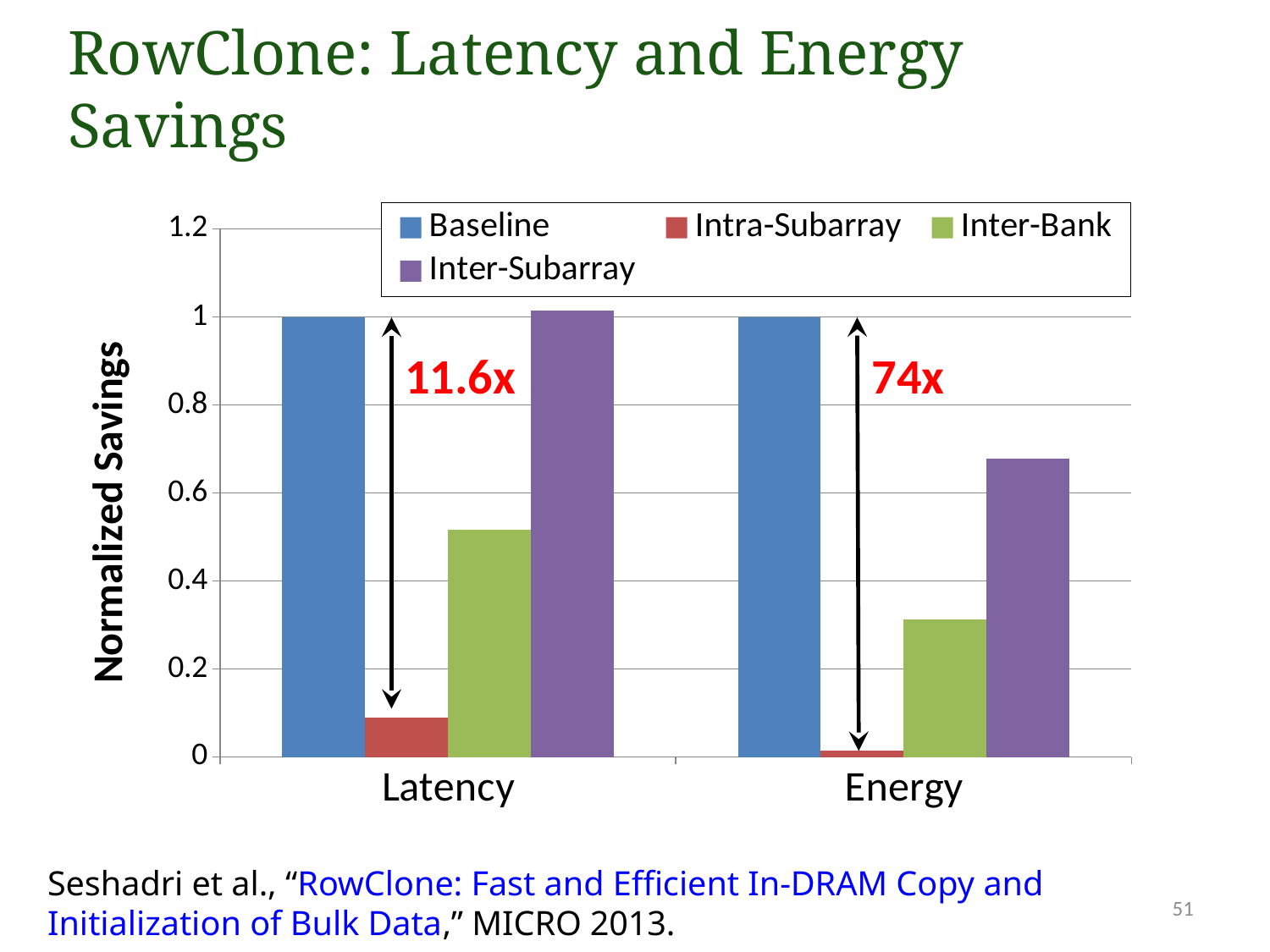
What is the label on the y axis? Normalized Savings What improvement factor is annotated above the Energy bars? 74x What kind of chart is shown on the slide? bar chart What is the Baseline value for Latency? 1 How many series does the legend list? 4 Is the Intra-Subarray value for Latency greater or less than 0.2? less Which series has the lowest value for Energy? Intra-Subarray How many categories are shown on the x axis? 2 Is the Inter-Bank value for Latency greater or less than 0.4? greater What is the Baseline value for Energy? 1 Is the Inter-Subarray value for Energy greater or less than 0.6? greater For Latency, which is larger: Inter-Bank or Inter-Subarray? Inter-Subarray